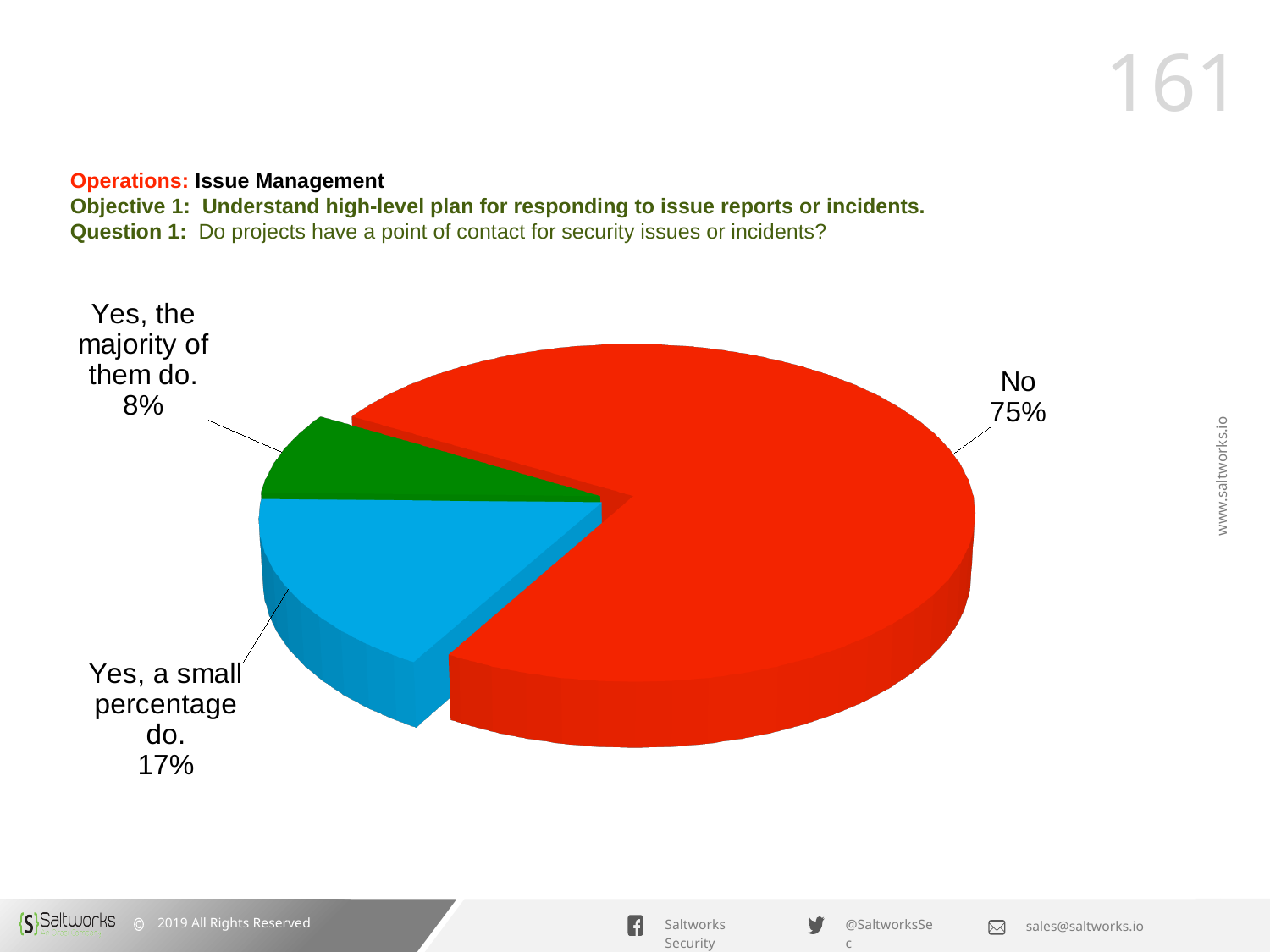
Which response has the smallest share of the pie? Yes, the majority of them do. What percentage of responses are 'Yes, the majority of them do.'? 8% What colour is the 'No' slice of the pie? Red How many slices does the pie chart have? 3 Which response has the largest share of the pie? No What kind of chart is shown on the slide? Pie chart What is the difference in percentage points between 'Yes, a small percentage do.' and 'Yes, the majority of them do.'? 9 What is the difference in percentage points between 'No' and 'Yes, a small percentage do.'? 58 What percentage of responses are 'Yes, a small percentage do.'? 17% Which is larger: the share for 'Yes, a small percentage do.' or 'Yes, the majority of them do.'? Yes, a small percentage do. What colour is the 'Yes, the majority of them do.' slice of the pie? Green What percentage of responses are 'No'? 75%